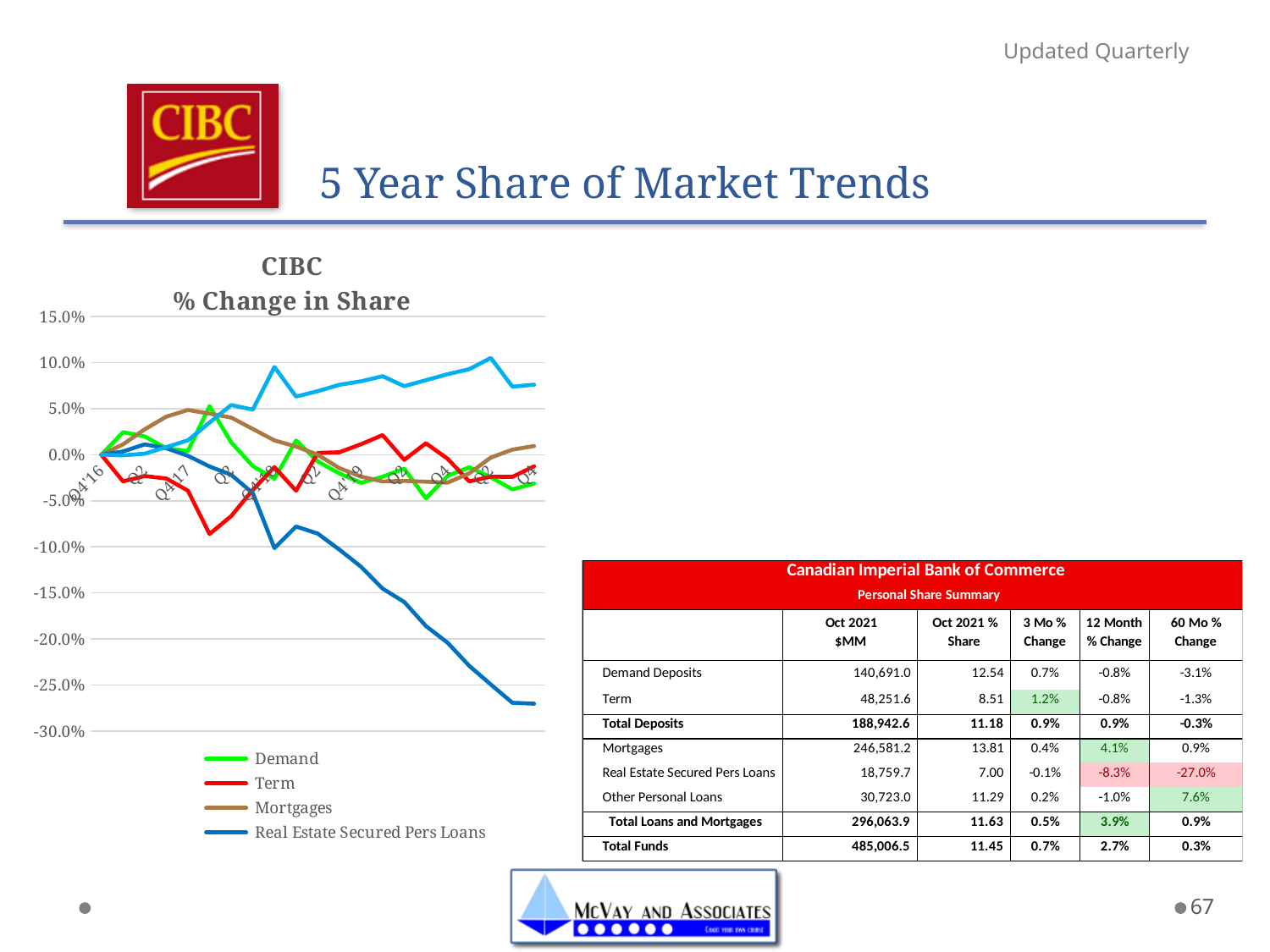
What is the title of the chart? CIBC % Change in Share What is the lowest value shown on the vertical axis of the chart? -30.0% At the right end of the chart, which is larger: the value for Demand or the value for Real Estate Secured Pers Loans? Demand Which series in the legend is drawn in green? Demand At the right end of the chart, is the value for Real Estate Secured Pers Loans greater or less than -20.0%? less At the right end of the chart, which is larger: the value for Mortgages or the value for Real Estate Secured Pers Loans? Mortgages At the right end of the chart, is the value for Real Estate Secured Pers Loans greater or less than -25.0%? less Which legend series has the lowest value at the right end of the chart? Real Estate Secured Pers Loans How many series does the legend of the chart list? 4 What kind of chart is shown on the slide? line chart Does the Real Estate Secured Pers Loans line rise or fall over the period shown? fall Is the lowest point of the Term line greater or less than -5.0%? less